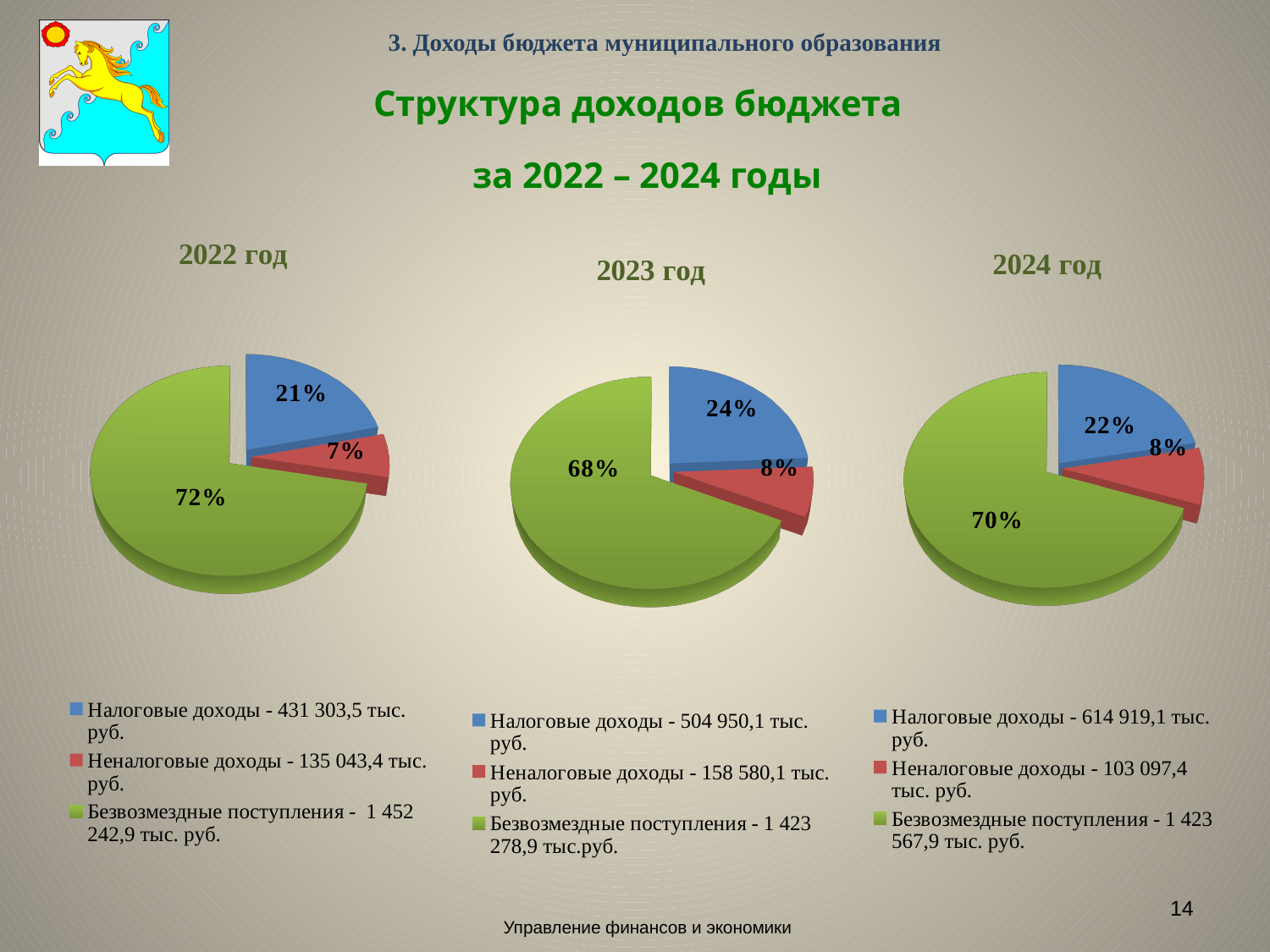
In the 2023 год pie chart, what share is shown for Налоговые доходы? 24% In the 2022 год pie chart, which category has the largest slice? Безвозмездные поступления In the 2024 год pie chart, what share is shown for Неналоговые доходы? 8% What colour represents Безвозмездные поступления in the pie charts? Green In the 2022 год pie chart, by how many percentage points does Безвозмездные поступления exceed Налоговые доходы? 51 percentage points In the 2024 год pie chart, which is larger: Налоговые доходы or Неналоговые доходы? Налоговые доходы In the 2023 год pie chart, which category has the smallest slice? Неналоговые доходы How many pie charts are shown on the slide? 3 How many slices does the 2024 год pie chart have? 3 In the 2022 год pie chart, what share is shown for Безвозмездные поступления? 72% What type of chart is used for the 2023 год data? Pie chart According to the legend of the 2024 год chart, what is the amount of Налоговые доходы? 614 919,1 тыс. руб.